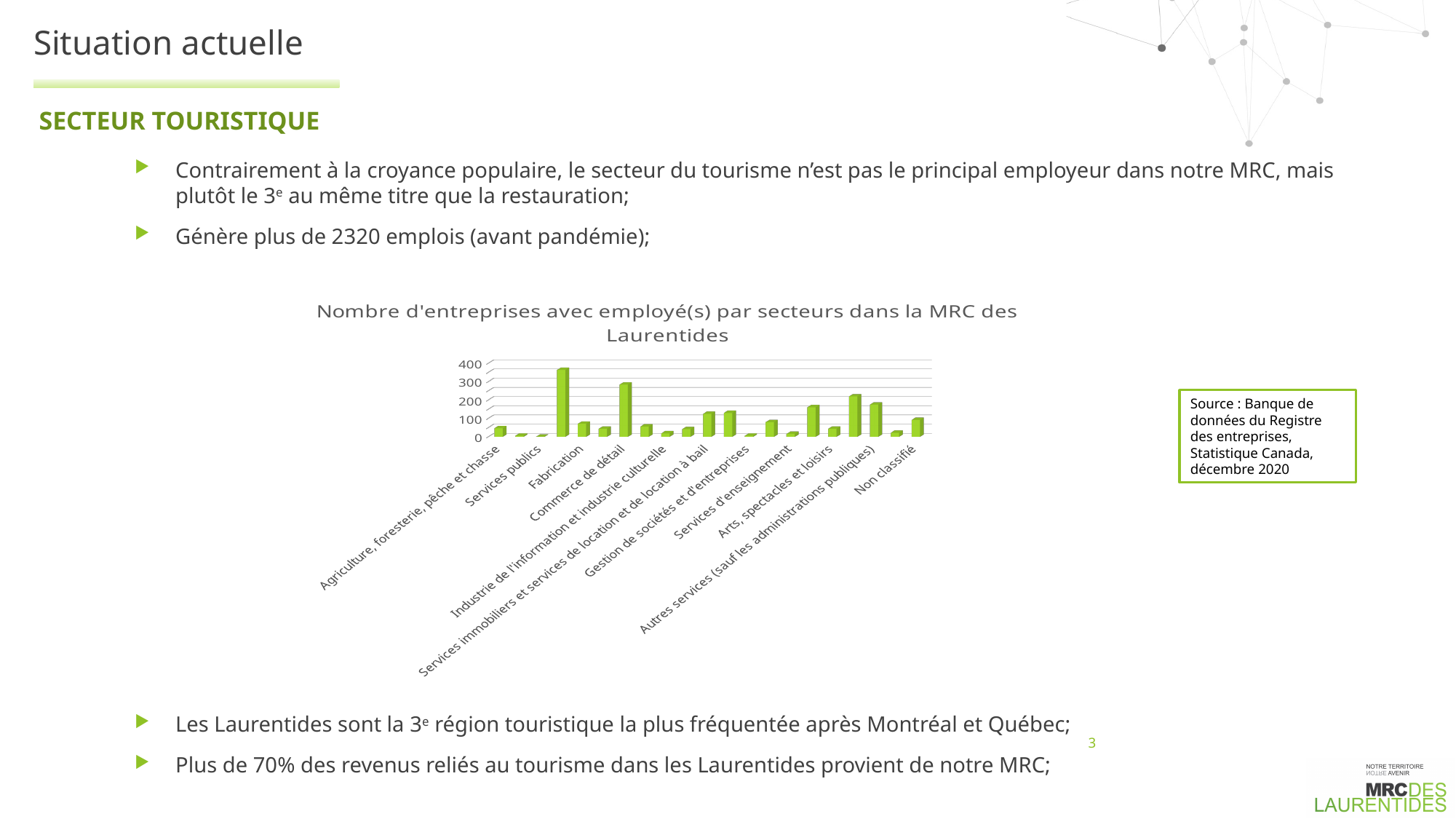
Is the value for Services d'enseignement greater or less than 100? less Which has the larger value, Commerce de détail or Fabrication? Commerce de détail Is the value for Commerce de détail greater or less than 200? greater What kind of chart is shown on the slide? Bar chart Which has the larger value, Autres services (sauf les administrations publiques) or Services d'enseignement? Autres services (sauf les administrations publiques) Which has the larger value, Commerce de détail or Agriculture, foresterie, pêche et chasse? Commerce de détail Is the value for Autres services (sauf les administrations publiques) greater or less than 100? greater What is the highest value shown on the chart's vertical axis? 400 What is the title of the chart? Nombre d'entreprises avec employé(s) par secteurs dans la MRC des Laurentides